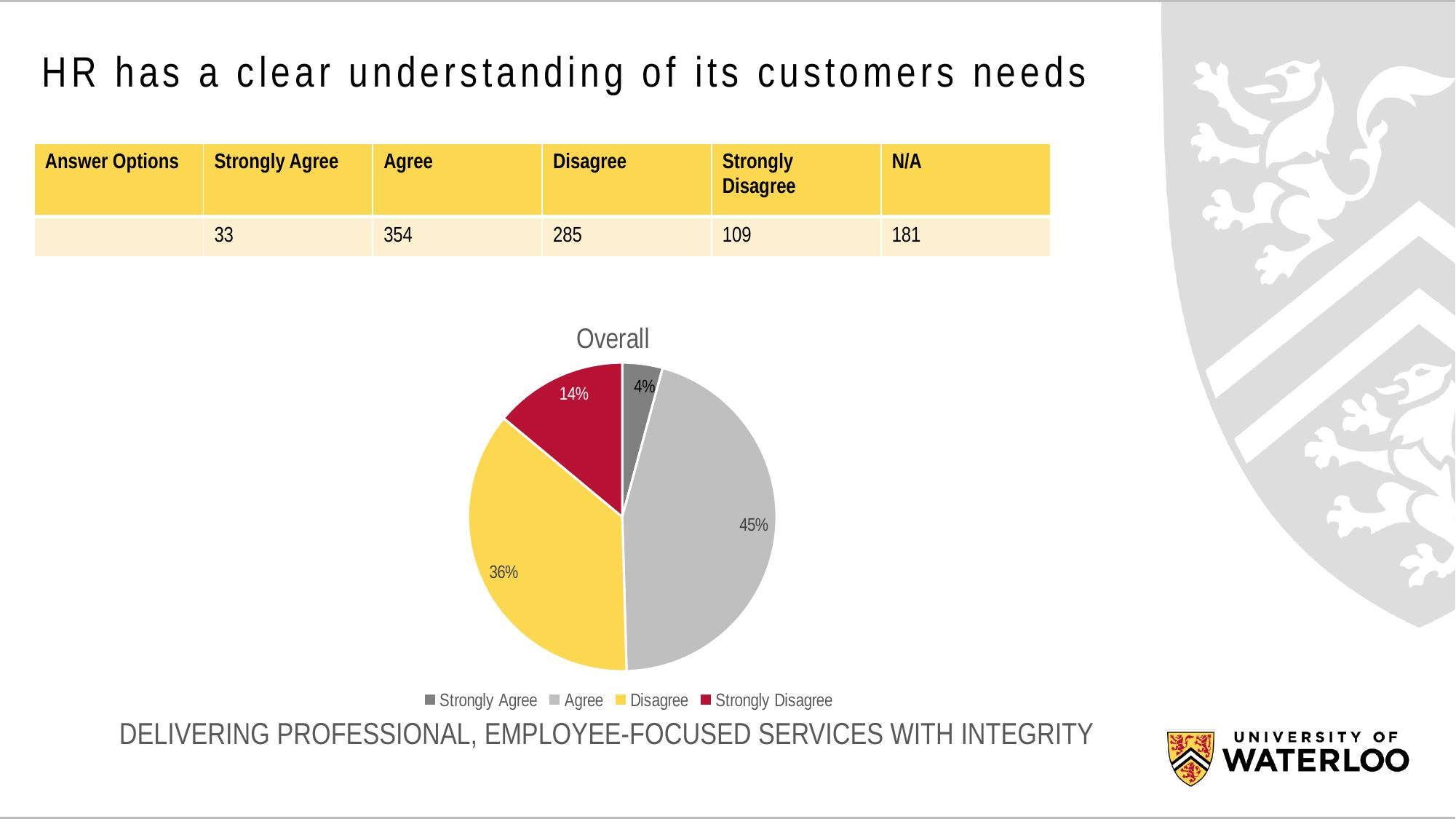
Which slice is larger, Disagree or Strongly Disagree? Disagree What share of the pie chart does Agree represent? 45% How many slices does the pie chart have? 4 What share of the pie chart does Strongly Disagree represent? 14% Which colour represents Strongly Disagree in the pie chart? Red What is the title of the pie chart? Overall Which category has the smallest slice in the pie chart? Strongly Agree What share of the pie chart does Strongly Agree represent? 4% What is the difference in percentage points between the Agree and Disagree slices? 9% Which category has the largest slice in the pie chart? Agree What type of chart is shown on the slide? Pie chart